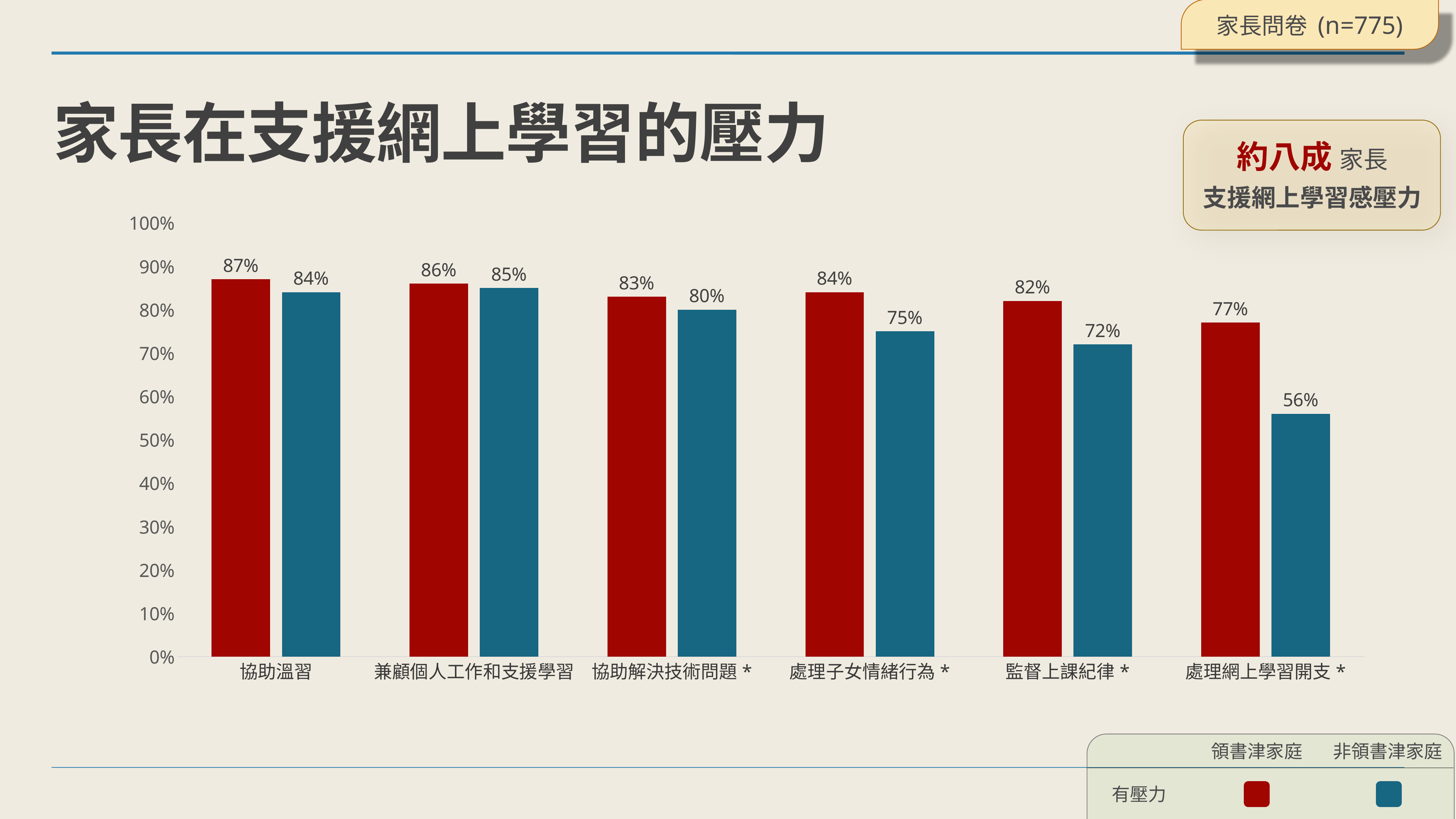
What is the value for 非領書津家庭 in the 處理網上學習開支 * category? 56% What kind of chart is shown on the slide? bar chart How many series does the legend list? 2 What colour represents 非領書津家庭 in the chart? blue What is the difference between 領書津家庭 and 非領書津家庭 in the 處理網上學習開支 * category? 21% Which category has the lowest value for 非領書津家庭? 處理網上學習開支 * What is the value for 非領書津家庭 in the 監督上課紀律 * category? 72% In the 監督上課紀律 * category, which series has the larger value, 領書津家庭 or 非領書津家庭? 領書津家庭 How many categories are shown on the x axis of the chart? 6 What is the value for 領書津家庭 in the 協助溫習 category? 87% Which category has the highest value for 領書津家庭? 協助溫習 What is the difference between 領書津家庭 and 非領書津家庭 in the 處理子女情緒行為 * category? 9%